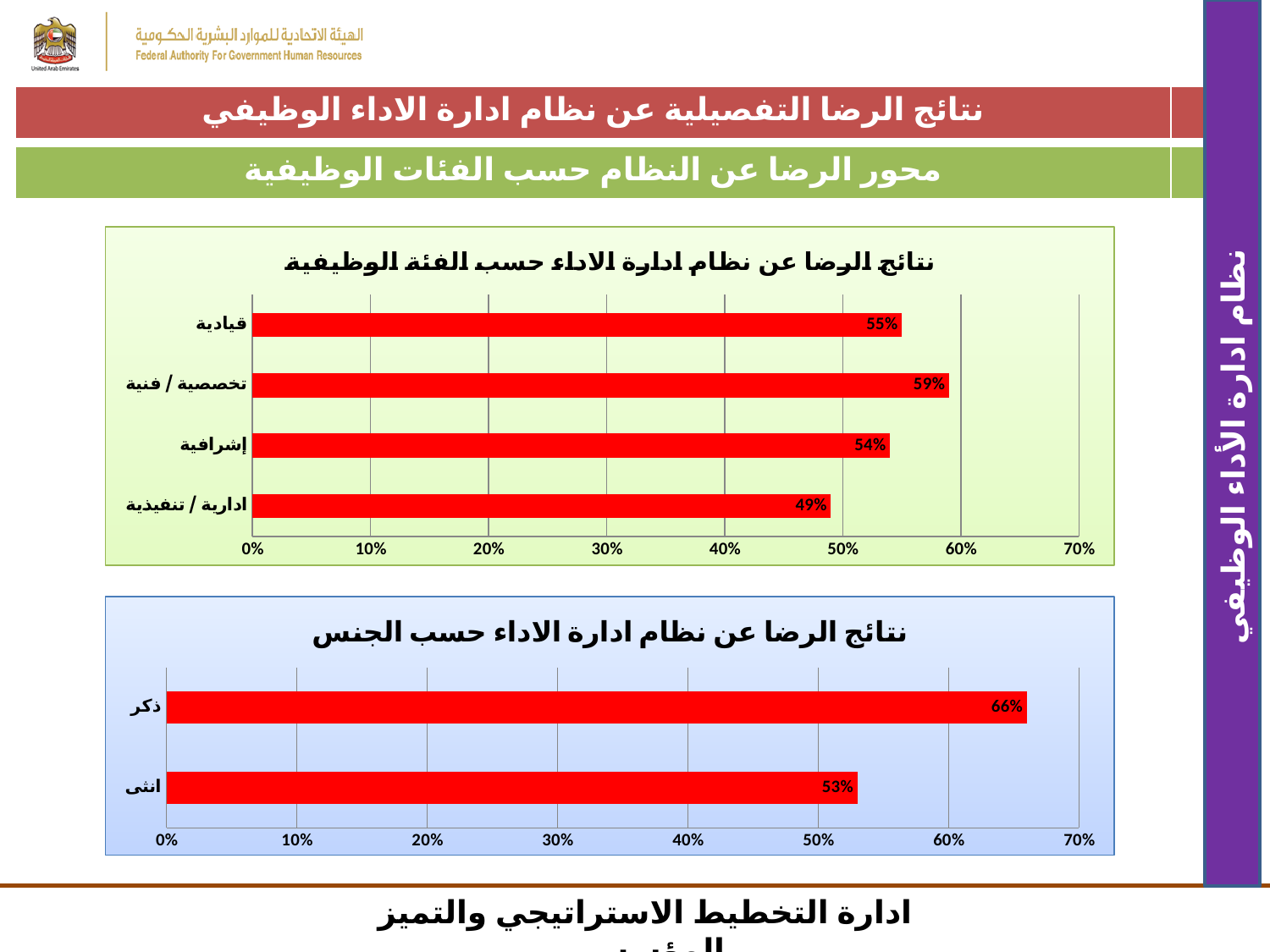
In the top chart (satisfaction by job category), which category has the highest value? تخصصية / فنية What type of chart is the bottom chart (satisfaction by gender)? Bar chart In the top chart (satisfaction by job category), what is the difference between تخصصية / فنية and ادارية / تنفيذية? 10% In the bottom chart (satisfaction by gender), what is the value for ذكر? 66% In the top chart (satisfaction by job category), how many job categories are shown? 4 In the top chart (satisfaction by job category), which category has the lowest value? ادارية / تنفيذية In the top chart (satisfaction by job category), what is the value for ادارية / تنفيذية? 49% In the bottom chart (satisfaction by gender), which is larger, ذكر or انثى? ذكر In the top chart (satisfaction by job category), what is the value for قيادية? 55% In the bottom chart (satisfaction by gender), what is the value for انثى? 53% In the top chart (satisfaction by job category), what is the value for تخصصية / فنية? 59% In the bottom chart (satisfaction by gender), what is the difference between ذكر and انثى? 13%